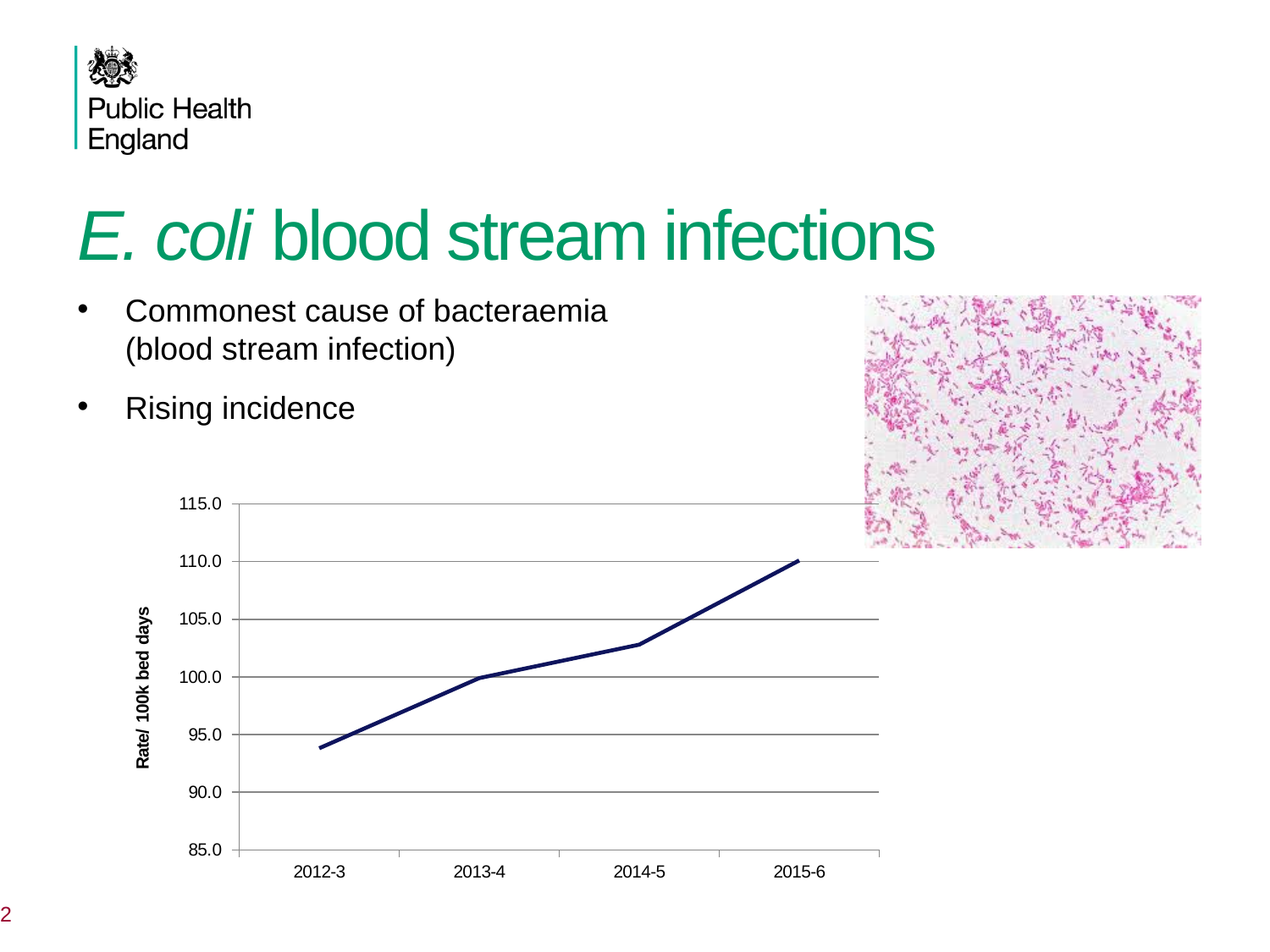
What kind of chart is shown on the slide? line chart Is the value for 2014-5 greater or less than 100.0? greater What is the lowest value shown on the vertical axis of the chart? 85.0 What is the label on the vertical axis of the chart? Rate/ 100k bed days Is the value for 2012-3 greater or less than 95.0? less Is the value for 2012-3 greater or less than 90.0? greater Which period has the larger rate, 2013-4 or 2014-5? 2014-5 Which period has the highest rate in the chart? 2015-6 Do the values in the chart rise or fall from 2012-3 to 2015-6? rise How many time periods are plotted on the x axis of the chart? 4 Which period has the lowest rate in the chart? 2012-3